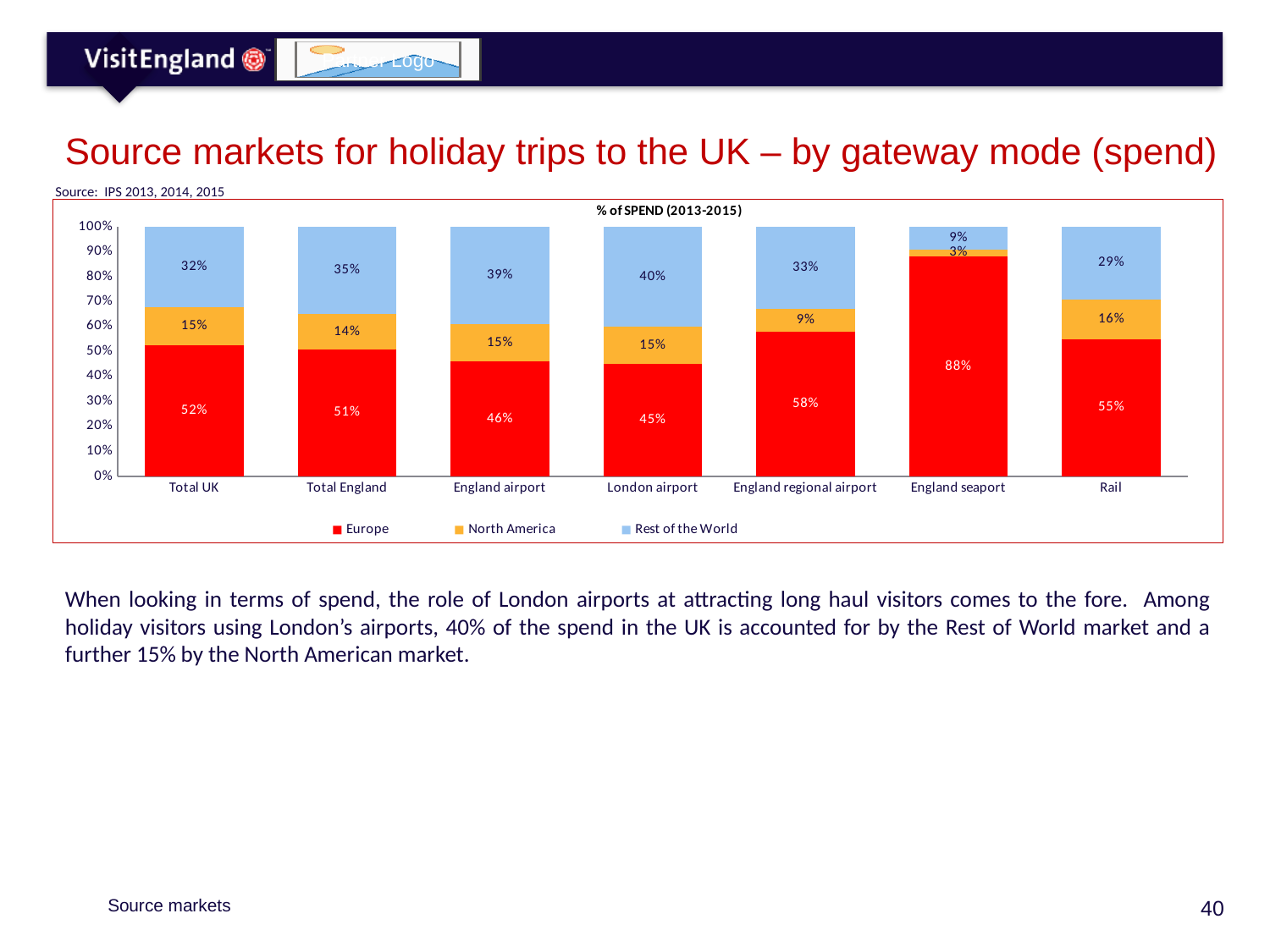
Which gateway mode has the lowest North America share of spend? England seaport What is the North America share of spend for Rail? 16% What is the Rest of the World share of spend for England seaport? 9% What is the difference between the Rest of the World share for London airport and for Total UK? 8 percentage points How many gateway mode categories are shown on the x axis? 7 What is the Europe share of spend for London airport? 45% How many series does the legend list? 3 What kind of chart is shown on the slide? Stacked bar chart Which colour represents North America in the chart? Orange What is the title shown above the chart? % of SPEND (2013-2015) Which is larger: the Europe share for England regional airport or for Rail? England regional airport Which gateway mode has the highest Europe share of spend? England seaport